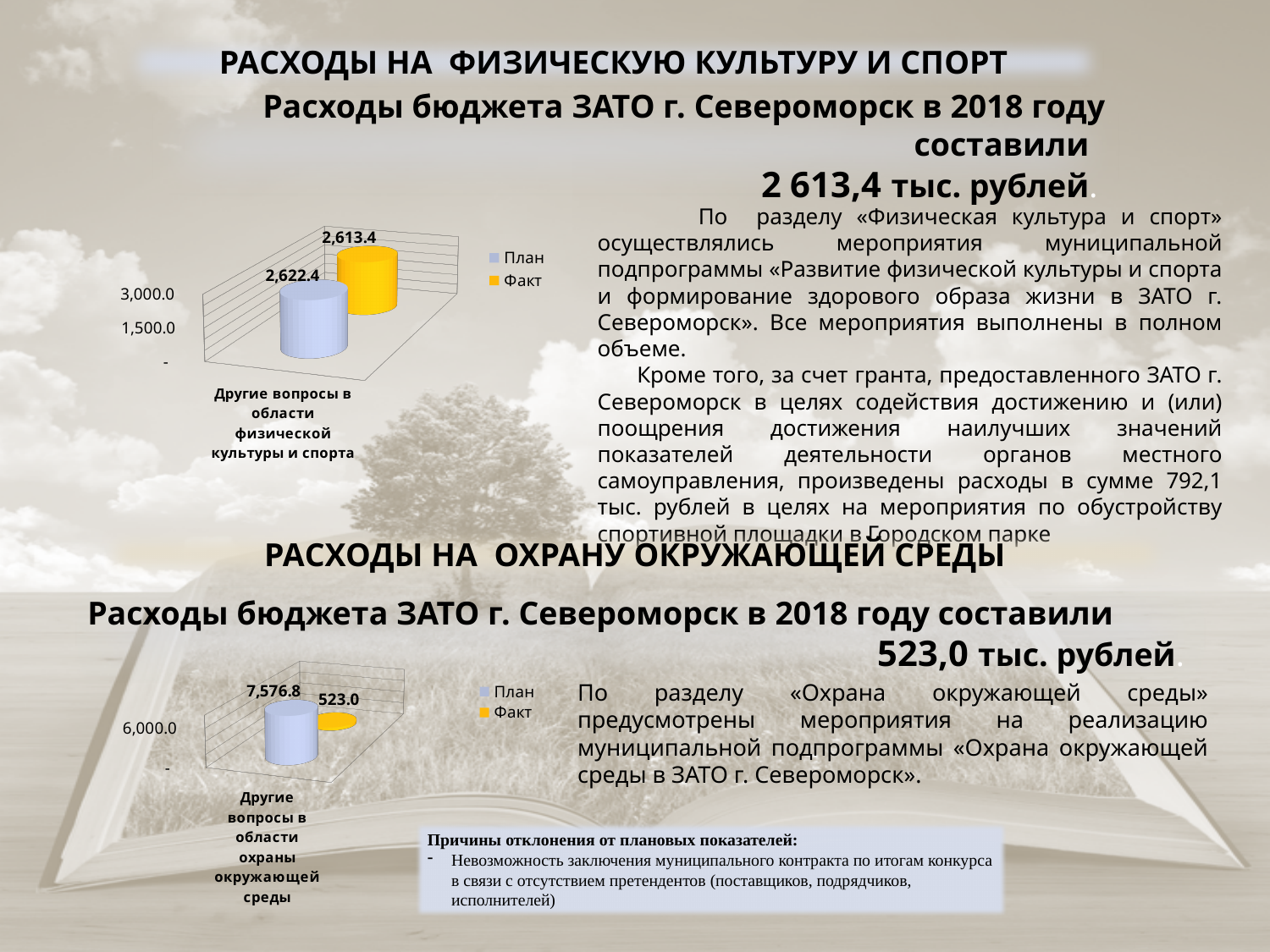
In the bottom chart, which series has the smaller value? Факт In the top chart, what is the difference between the План and Факт values? 9.0 In the bottom chart, what is the value for План? 7,576.8 In the bottom chart, what is the value for Факт? 523.0 What type of chart is the bottom chart? bar chart In the top chart, which series has the larger value, План or Факт? План In the bottom chart, what is the difference between the План and Факт values? 7,053.8 In the top chart, what is the value for Факт? 2,613.4 In the bottom chart, is the value for План greater or less than 6,000.0? greater In the top chart, how many series does the legend list? 2 In the top chart, what is the value for План? 2,622.4 In the top chart, what category is shown on the x axis? Другие вопросы в области физической культуры и спорта